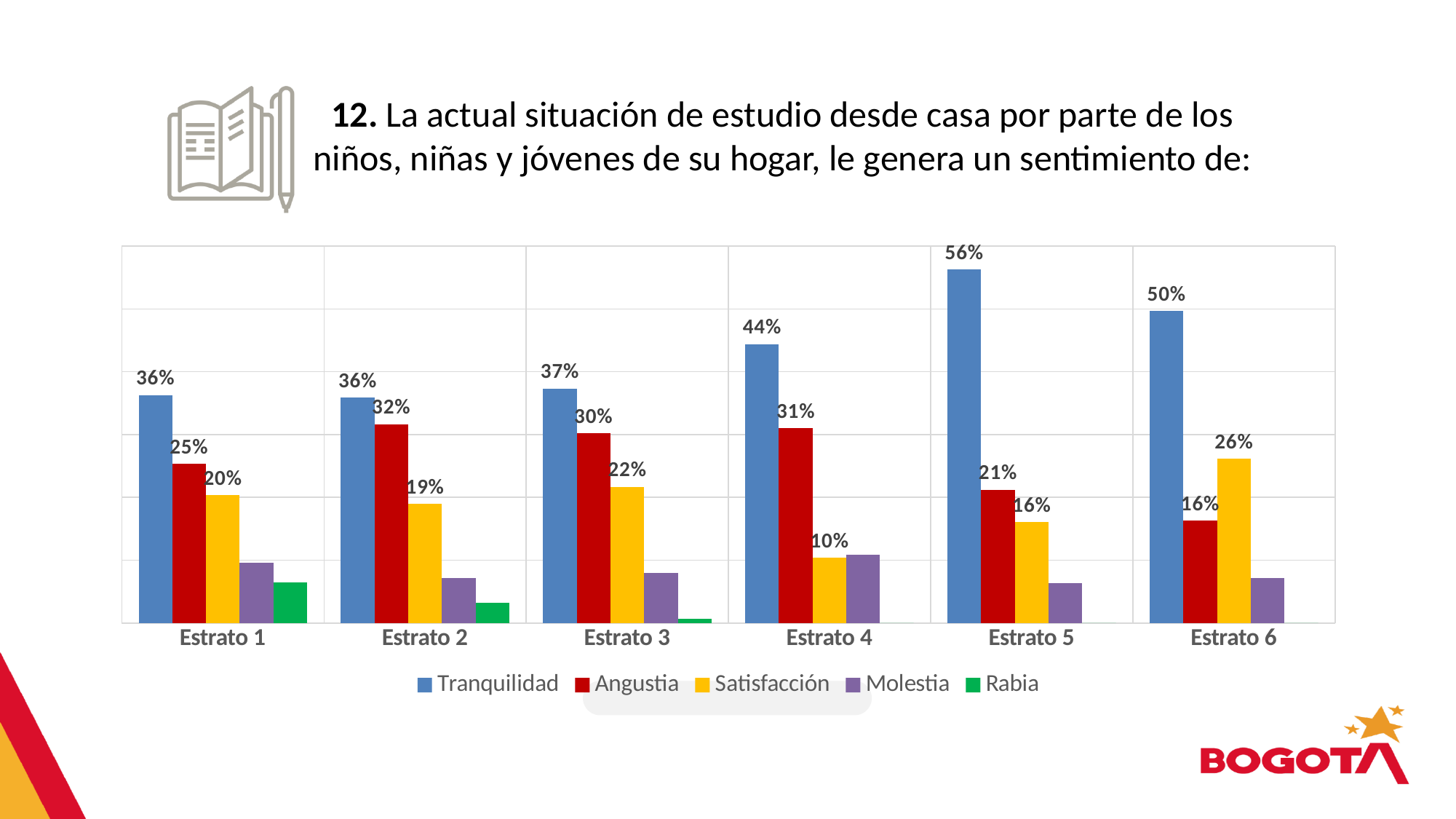
What is the value for Angustia in Estrato 2? 32% What is the value for Tranquilidad in Estrato 5? 56% What is the value for Satisfacción in Estrato 6? 26% Which series is shown in green in the legend? Rabia What is the value for Satisfacción in Estrato 4? 10% How many estrato categories are shown on the x axis? 6 Which is larger in Estrato 6: Angustia or Satisfacción? Satisfacción What is the difference between the Tranquilidad values for Estrato 5 and Estrato 1? 20% What kind of chart is shown on the slide? Bar chart Which estrato has the lowest value for Angustia? Estrato 6 Which estrato has the highest value for Tranquilidad? Estrato 5 How many series does the legend list? 5